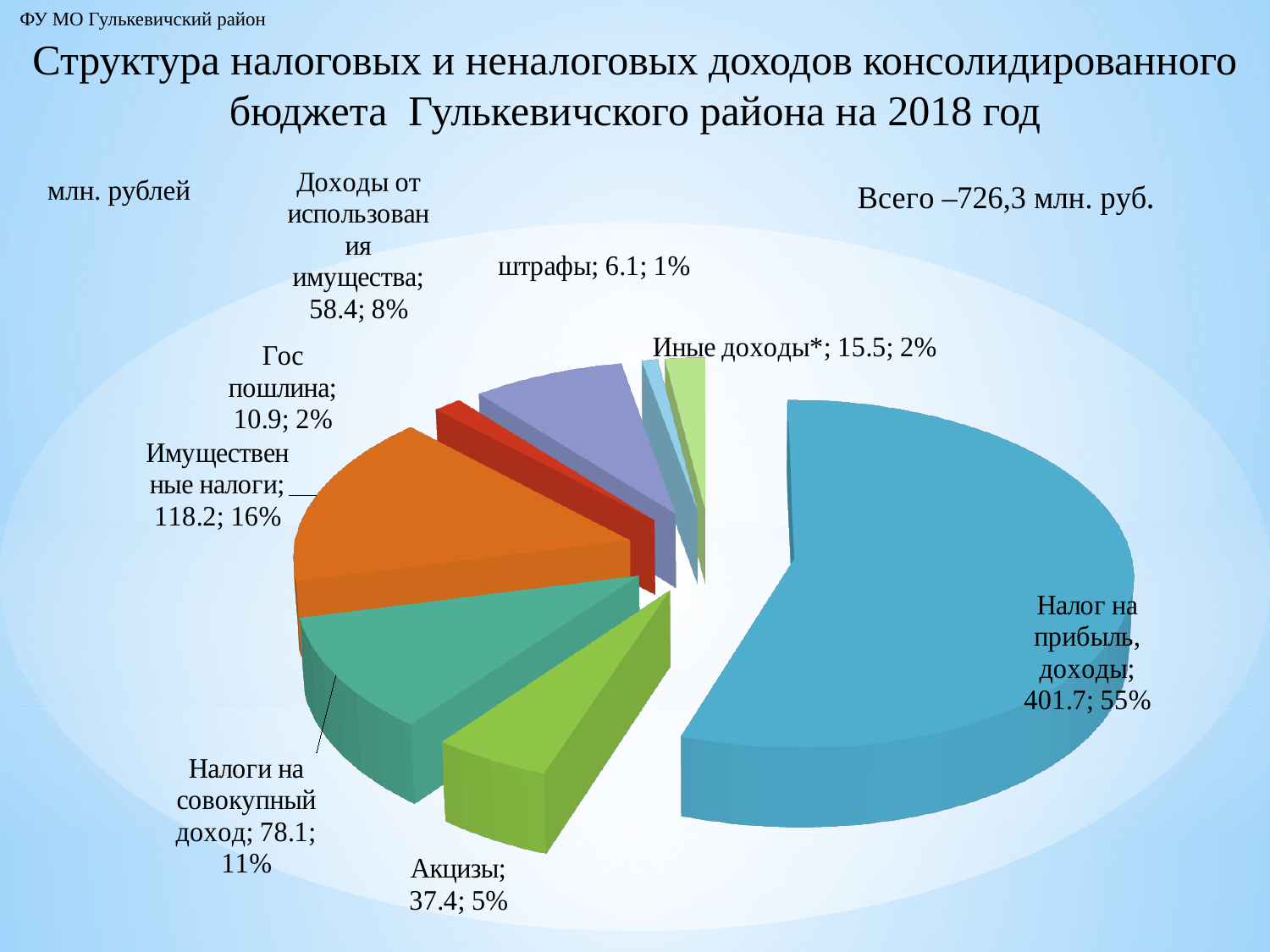
What is the value for Акцизы? 37.4 Which category has the smallest slice of the pie? штрафы What is the difference between the values for Имущественные налоги and Налоги на совокупный доход? 40.1 What share of the pie does Имущественные налоги represent? 16% What is the value for Налог на прибыль, доходы? 401.7 What is the value for Иные доходы*? 15.5 What share of the pie does Гос пошлина represent? 2% What total amount is stated on the slide for all revenues? 726,3 млн. руб. Which category has the largest slice of the pie? Налог на прибыль, доходы How many slices does the pie chart have? 8 Which is larger, the value for Доходы от использования имущества or the value for Акцизы? Доходы от использования имущества What kind of chart is shown on the slide? pie chart